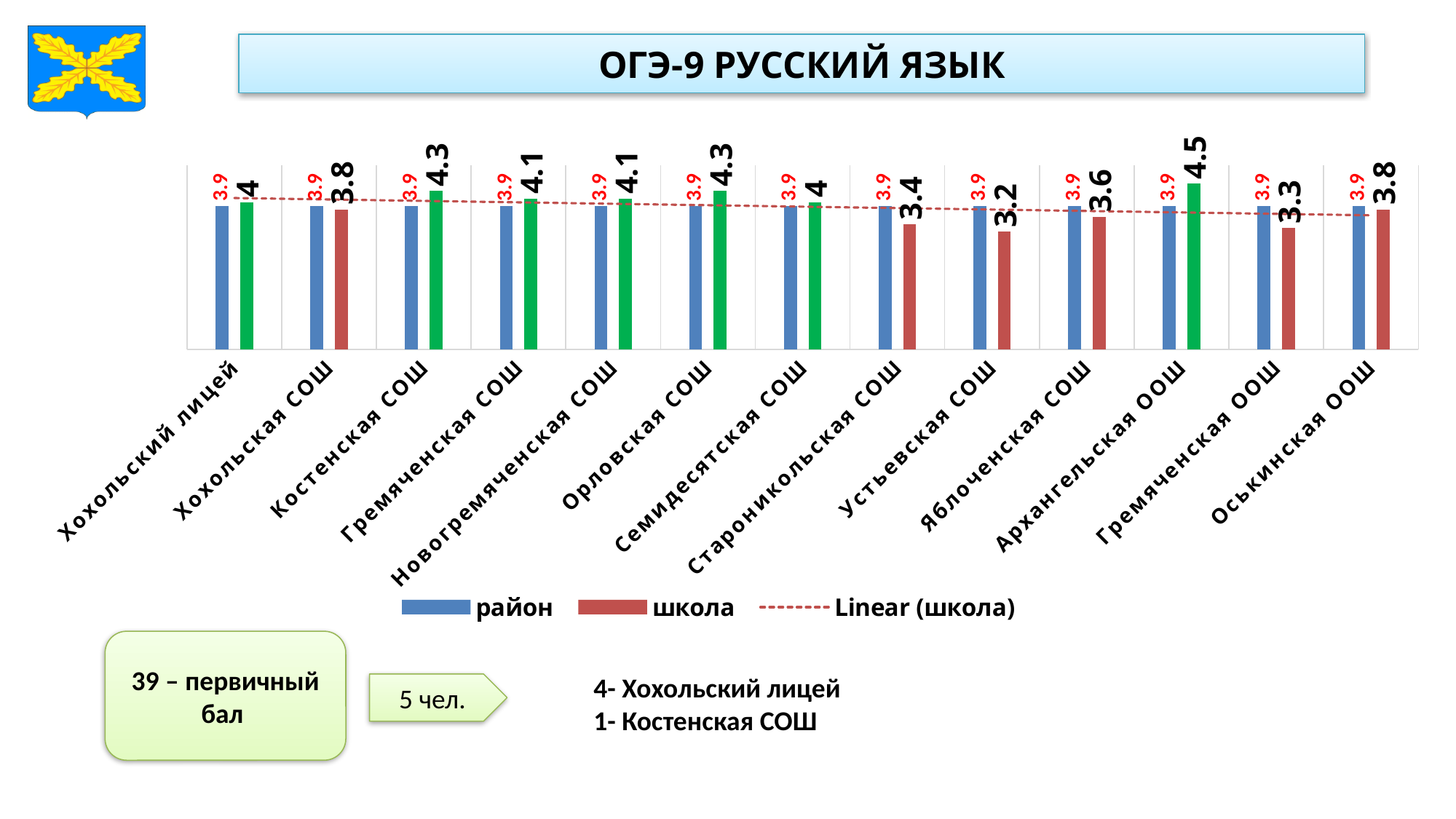
How many entries does the legend list? 3 What is the difference between the школа values for Архангельская ООШ and Устьевская СОШ? 1.3 What is the difference between the школа value for Оськинская ООШ and the район value? 0.1 What is the title of the slide's chart? ОГЭ-9 РУССКИЙ ЯЗЫК Which school has the lowest школа value? Устьевская СОШ How many schools are shown on the x axis? 13 Which is larger, the школа value for Яблоченская СОШ or for Гремяченская ООШ? Яблоченская СОШ What kind of chart is shown on the slide? bar chart Which school has the highest школа value? Архангельская ООШ What is the район value shown for Хохольский лицей? 3.9 What is the школа value for Костенская СОШ? 4.3 What is the школа value for Устьевская СОШ? 3.2